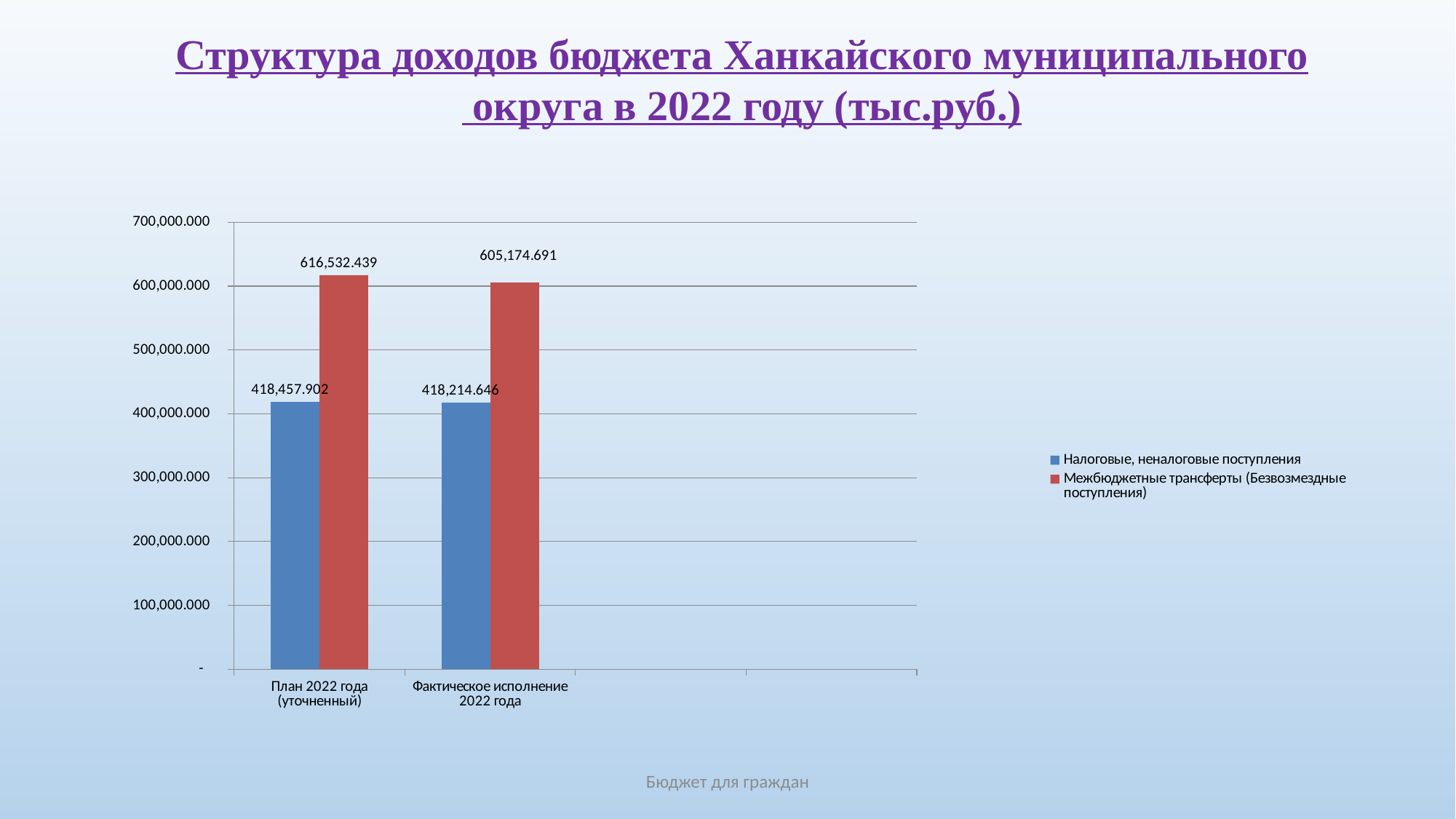
Which colour represents Налоговые, неналоговые поступления in the chart? Blue Is the value of Межбюджетные трансферты (Безвозмездные поступления) for Фактическое исполнение 2022 года greater or less than 600,000.000? greater What is the difference between Межбюджетные трансферты (Безвозмездные поступления) for План 2022 года (уточненный) and for Фактическое исполнение 2022 года? 11,357.748 What is the value of Налоговые, неналоговые поступления for План 2022 года (уточненный)? 418,457.902 How many categories are shown on the x axis? 2 What is the value of Межбюджетные трансферты (Безвозмездные поступления) for План 2022 года (уточненный)? 616,532.439 What is the difference between Межбюджетные трансферты (Безвозмездные поступления) and Налоговые, неналоговые поступления for План 2022 года (уточненный)? 198,074.537 What is the value of Межбюджетные трансферты (Безвозмездные поступления) for Фактическое исполнение 2022 года? 605,174.691 What is the value of Налоговые, неналоговые поступления for Фактическое исполнение 2022 года? 418,214.646 Which series has the highest value in the chart? Межбюджетные трансферты (Безвозмездные поступления) How many series does the legend list? 2 What type of chart is shown on the slide? Bar chart